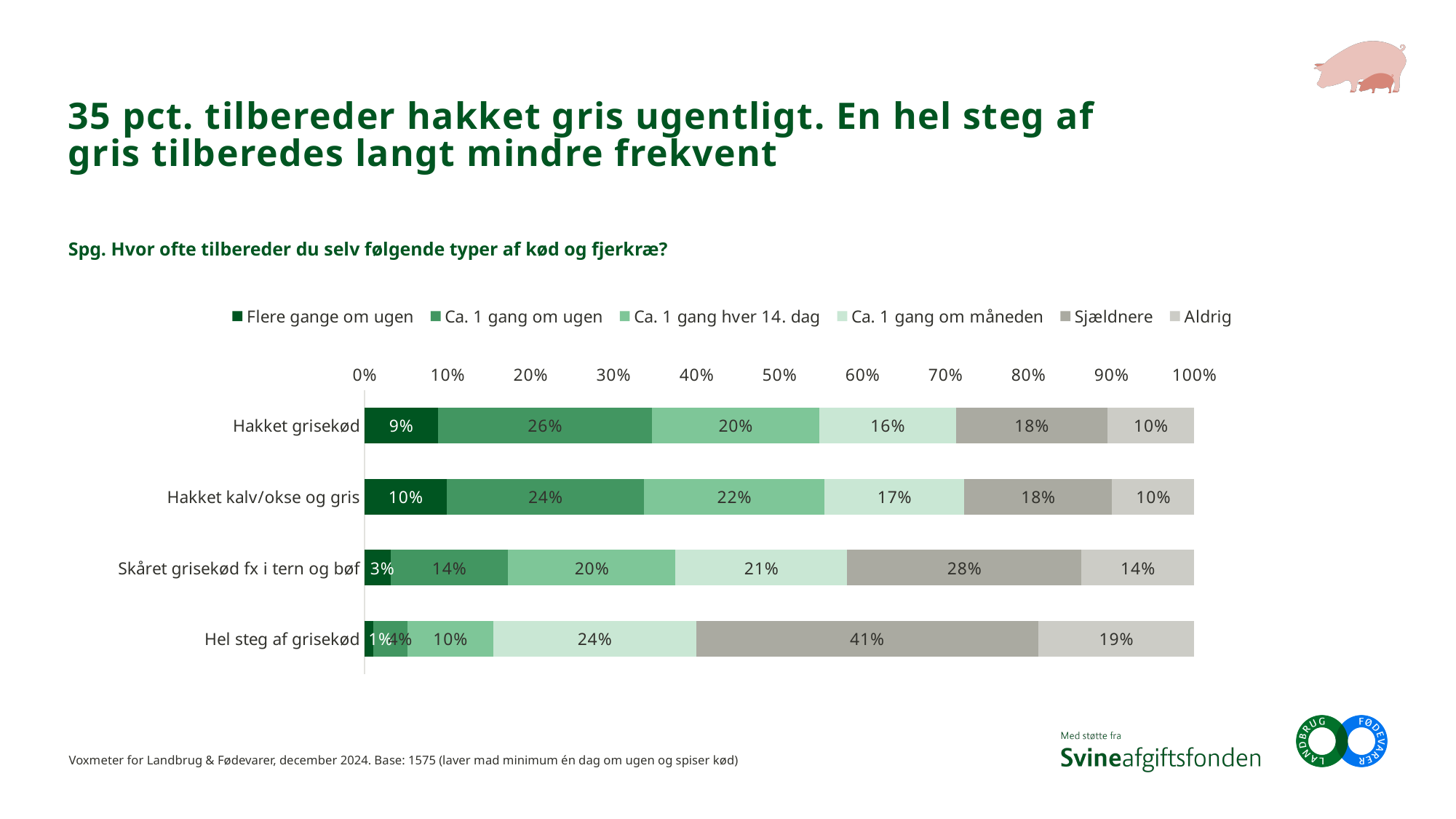
What percentage of respondents prepare Hakket grisekød 'Ca. 1 gang om ugen'? 26% What is the 'Aldrig' value for Skåret grisekød fx i tern og bøf? 14% How many series does the legend list? 6 Which category has the highest 'Sjældnere' value? Hel steg af grisekød How many categories are shown on the chart? 4 Which is larger: the 'Ca. 1 gang hver 14. dag' value for Hakket kalv/okse og gris or for Hakket grisekød? Hakket kalv/okse og gris What kind of chart is shown on the slide? Stacked bar chart Which category has the lowest 'Flere gange om ugen' value? Hel steg af grisekød What is the combined share of 'Flere gange om ugen' and 'Ca. 1 gang om ugen' for Hakket grisekød? 35% What is the difference between the 'Sjældnere' values for Hel steg af grisekød and Skåret grisekød fx i tern og bøf? 13% What is the 'Flere gange om ugen' value for Hakket kalv/okse og gris? 10% What is the 'Sjældnere' value for Hel steg af grisekød? 41%